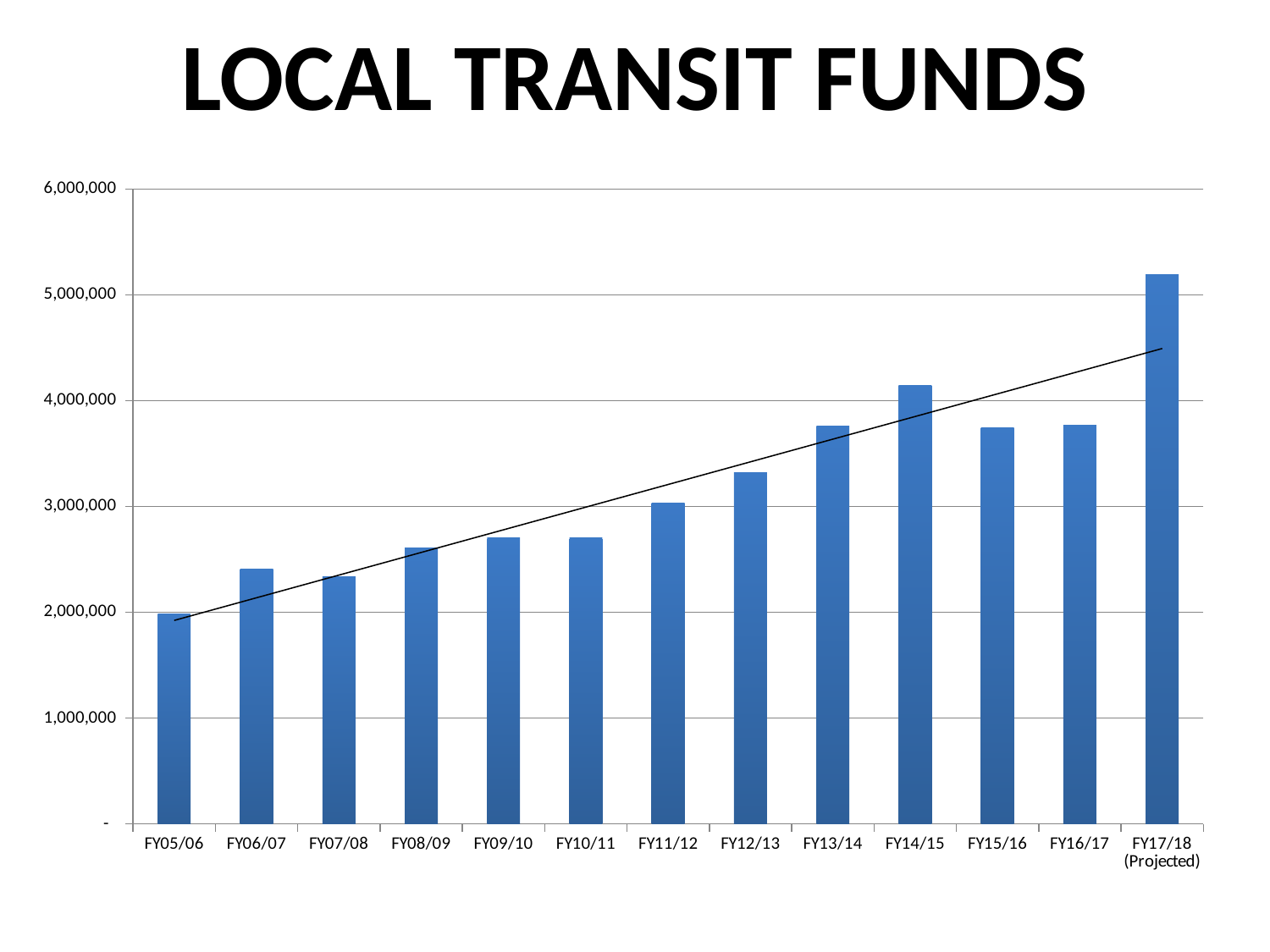
How many fiscal years are shown on the x axis? 13 Do the values generally rise or fall from FY05/06 to FY17/18 (Projected)? Rise Which fiscal year has the lowest value? FY05/06 Is the value for FY12/13 greater or less than 3,000,000? greater Which is larger, the value for FY06/07 or FY05/06? FY06/07 Is the value for FY13/14 greater or less than 4,000,000? less What kind of chart is shown on the slide? Bar chart Which fiscal year has the highest value? FY17/18 (Projected) Is the value for FY17/18 (Projected) greater or less than 5,000,000? greater Which is larger, the value for FY14/15 or FY13/14? FY14/15 What is the title of the chart? LOCAL TRANSIT FUNDS